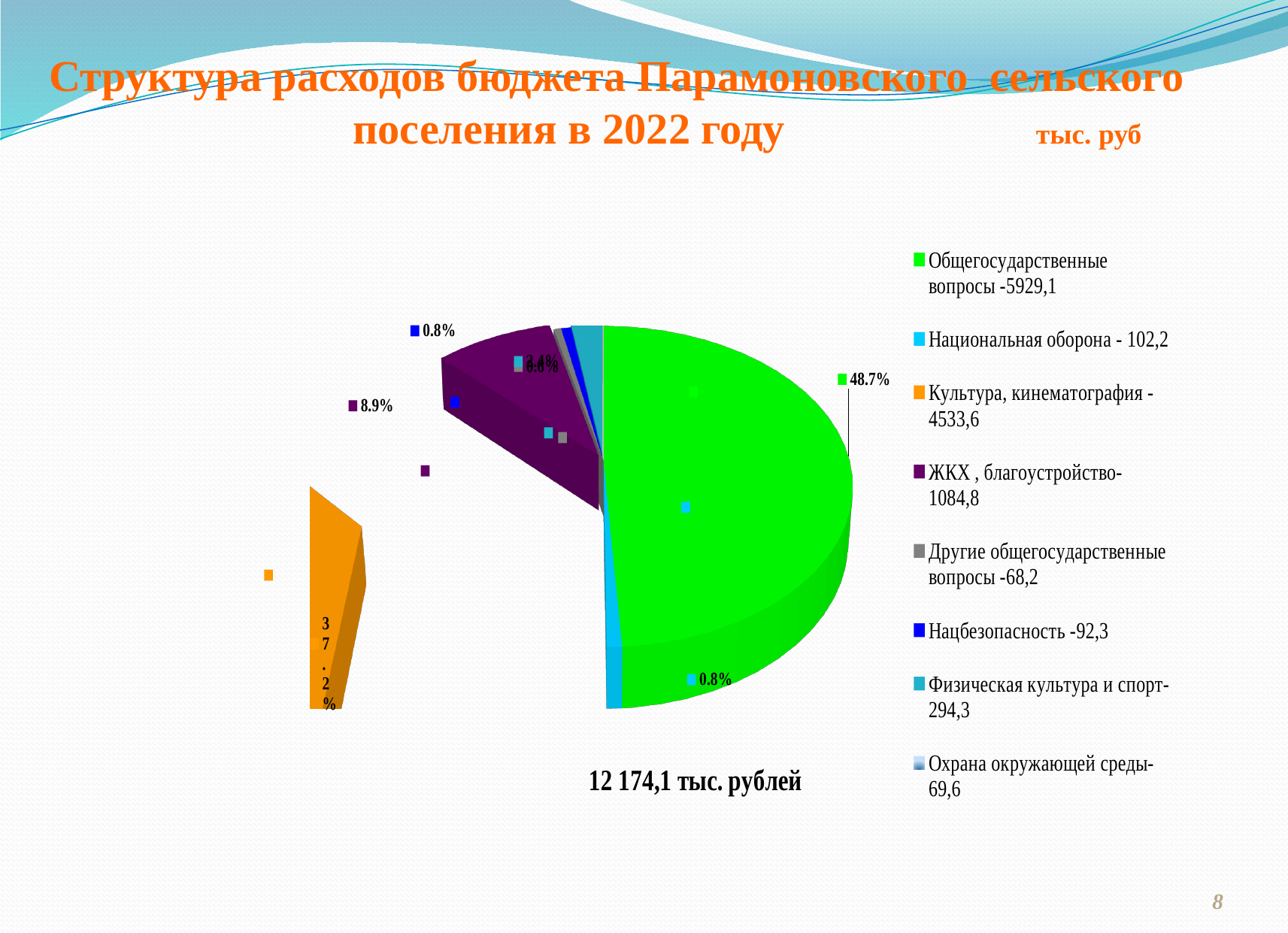
How many categories does the legend of the pie chart list? 8 What is the value for Общегосударственные вопросы shown in the legend? 5929,1 Which category has the largest share of the pie? Общегосударственные вопросы What is the value for Физическая культура и спорт shown in the legend? 294,3 What share of the pie does Общегосударственные вопросы take? 48.7% What total amount of expenditures is printed below the pie chart? 12 174,1 тыс. рублей Which is larger: the value for Национальная оборона or the value for Нацбезопасность? Национальная оборона What share of the pie does ЖКХ, благоустройство take? 8.9% What kind of chart is shown on the slide? pie chart What share of the pie does Культура, кинематография take? 37.2% What is the value for Культура, кинематография shown in the legend? 4533,6 Which category has the smallest value in the legend? Другие общегосударственные вопросы